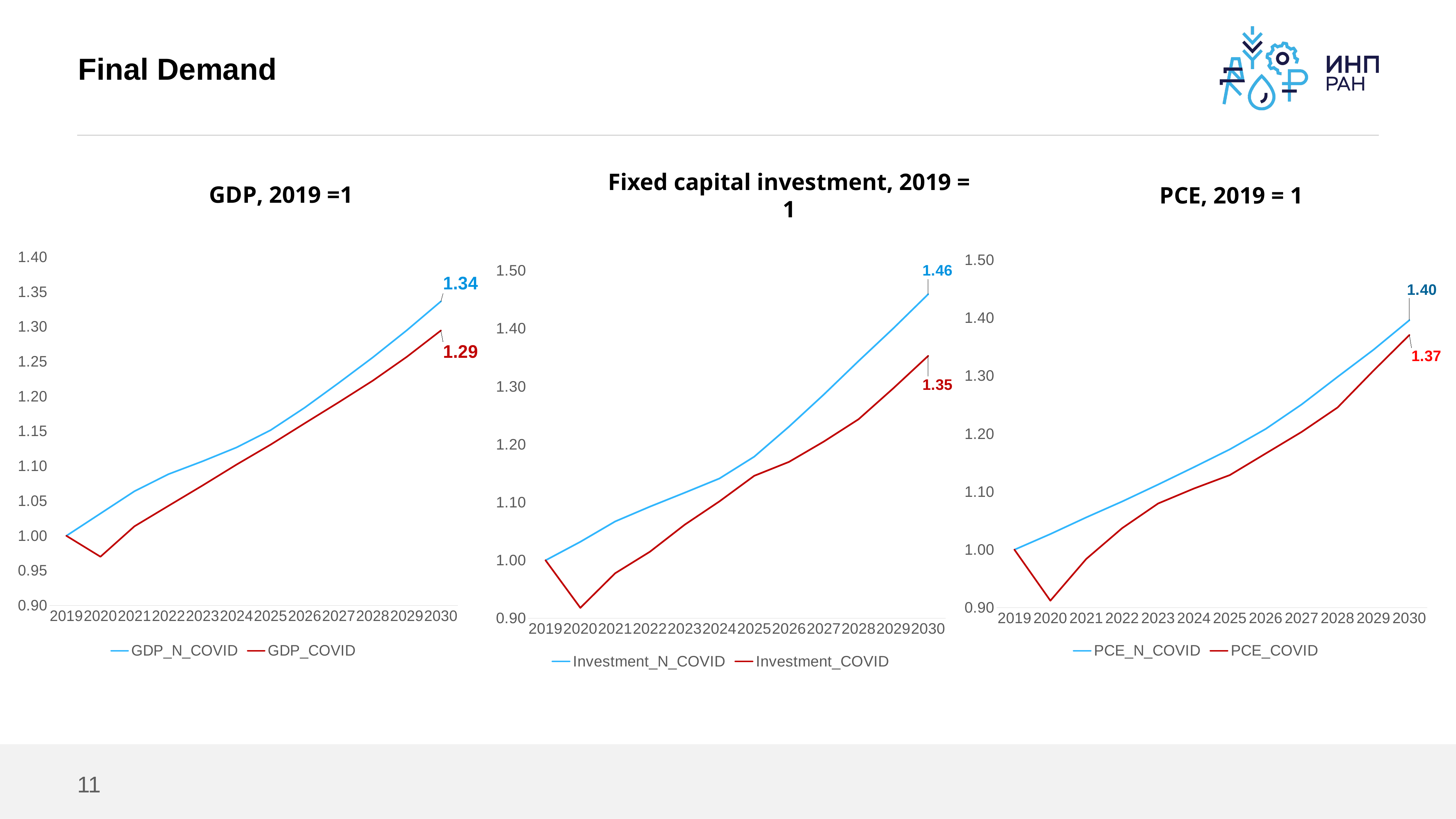
In the GDP, 2019 =1 chart, what is the value of GDP_N_COVID in 2030? 1.34 In the Fixed capital investment, 2019 = 1 chart, what is the value of Investment_N_COVID in 2030? 1.46 In the PCE, 2019 = 1 chart, how many years are shown on the x axis? 12 What type of chart is the PCE, 2019 = 1 chart? Line chart In the PCE, 2019 = 1 chart, what is the difference between PCE_N_COVID and PCE_COVID in 2030? 0.03 In the GDP, 2019 =1 chart, which series has the higher value in 2030, GDP_N_COVID or GDP_COVID? GDP_N_COVID In the Fixed capital investment, 2019 = 1 chart, is the value of Investment_COVID in 2020 greater or less than 1.00? less In the GDP, 2019 =1 chart, how many series does the legend list? 2 In the GDP, 2019 =1 chart, what is the value of GDP_COVID in 2030? 1.29 In the Fixed capital investment, 2019 = 1 chart, what is the difference between Investment_N_COVID and Investment_COVID in 2030? 0.11 In the Fixed capital investment, 2019 = 1 chart, what is the value of Investment_COVID in 2030? 1.35 In the PCE, 2019 = 1 chart, what is the value of PCE_COVID in 2030? 1.37